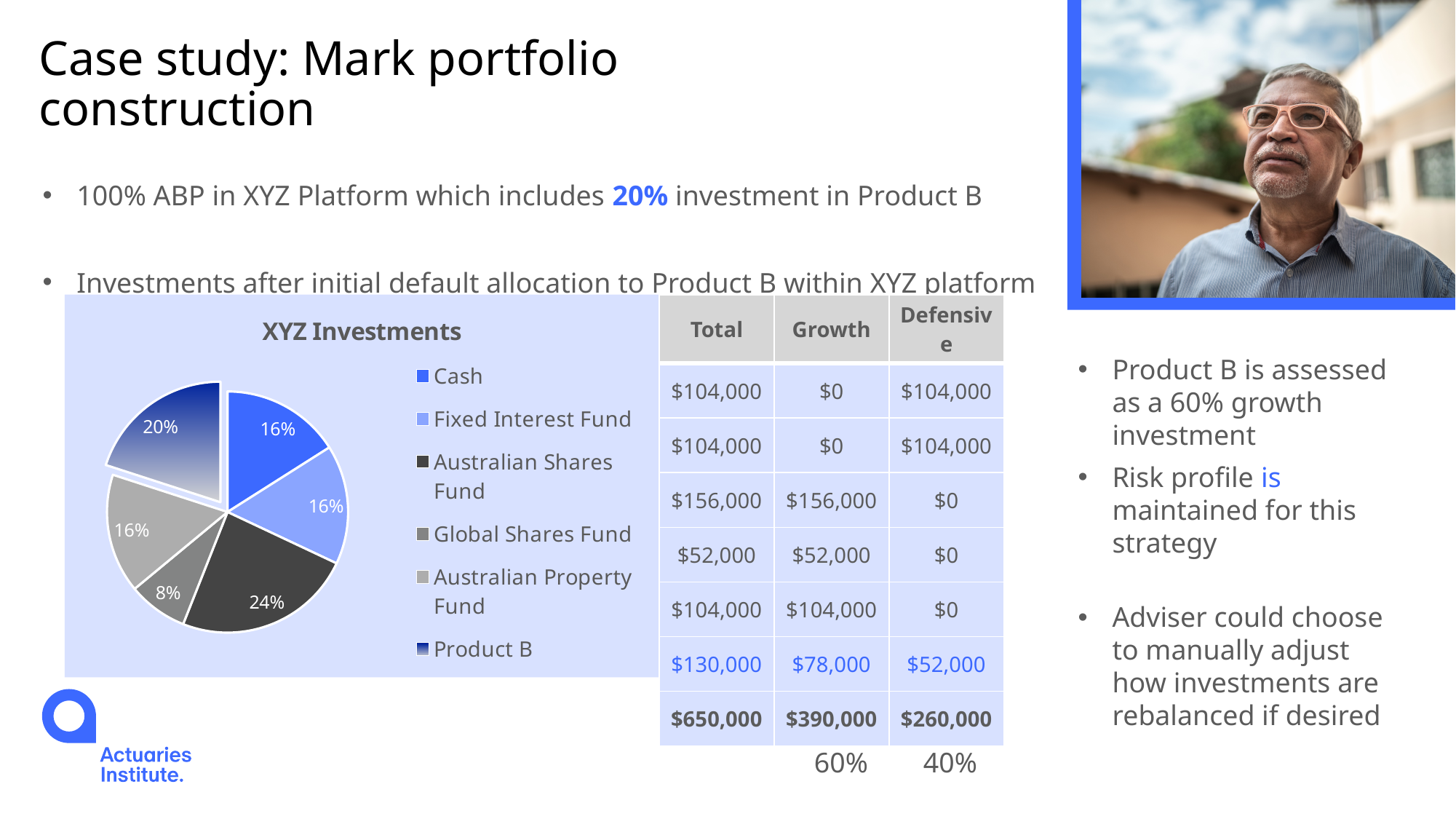
Which slice of the XYZ Investments pie chart is pulled out (exploded) from the rest of the pie? Product B How many slices does the XYZ Investments pie chart have? 6 What share of the XYZ Investments pie is the Australian Shares Fund? 24% What kind of chart is shown under the title "XYZ Investments"? Pie chart What percentage is shown for Cash in the XYZ Investments pie chart? 16% In the XYZ Investments pie chart, which is larger: Product B or the Australian Property Fund? Product B How many entries does the legend of the XYZ Investments pie chart list? 6 Which category has the largest slice in the XYZ Investments pie chart? Australian Shares Fund Which category has the smallest slice in the XYZ Investments pie chart? Global Shares Fund What share of the XYZ Investments pie is Product B? 20% What share of the XYZ Investments pie is the Global Shares Fund? 8% In the XYZ Investments pie chart, what is the difference in percentage points between the Australian Shares Fund and the Global Shares Fund? 16